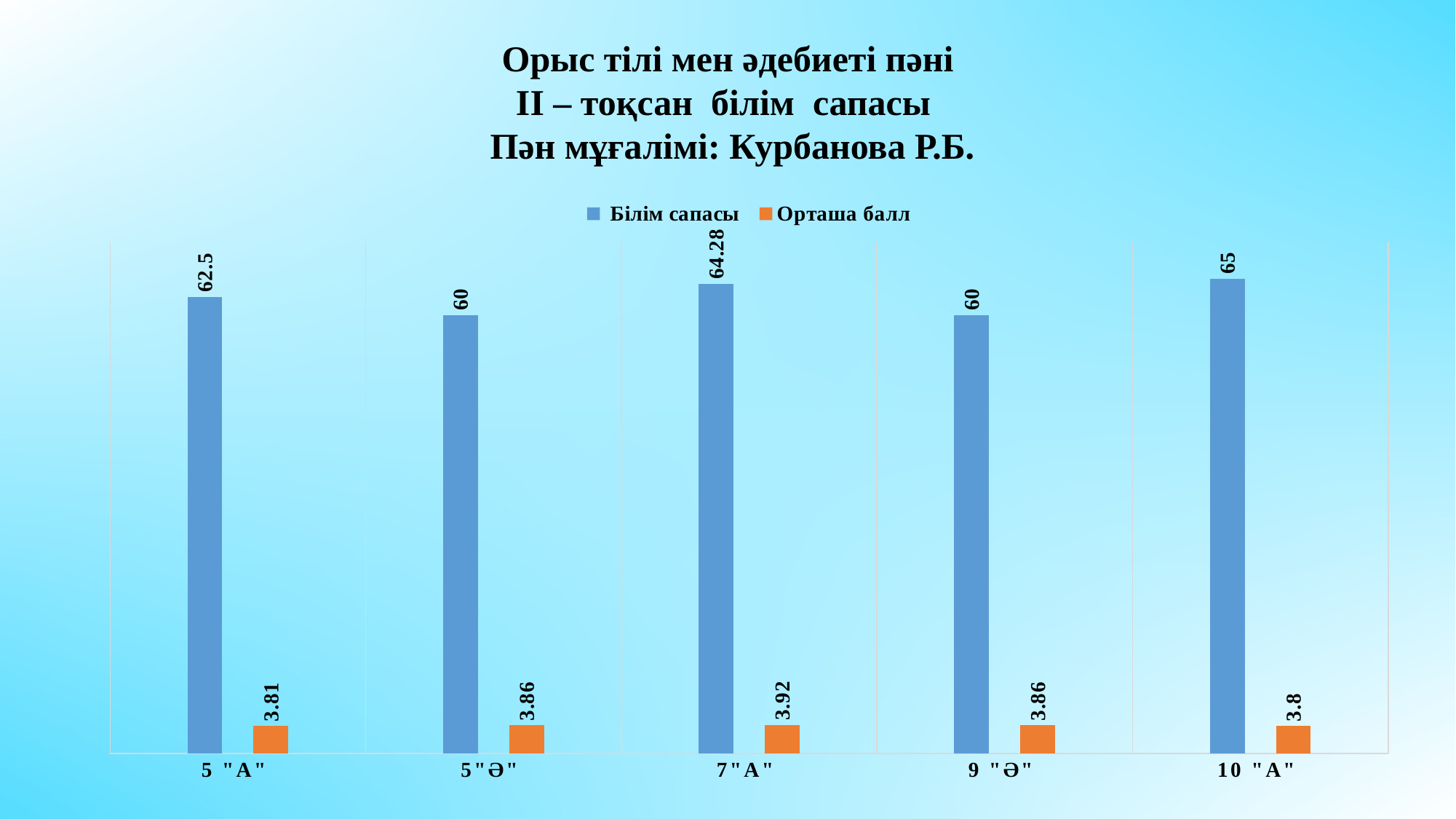
What kind of chart is shown on the slide? Bar chart What is the Орташа балл value for 5 "Ә"? 3.86 What is the Білім сапасы value for 7 "А"? 64.28 What is the Орташа балл value for 10 "А"? 3.8 Which class has the highest Орташа балл value? 7 "А" Which class has the lowest Орташа балл value? 10 "А" How many series does the legend list? 2 What is the difference between the Білім сапасы values for 10 "А" and 5 "А"? 2.5 What is the difference between the Орташа балл values for 7 "А" and 5 "А"? 0.11 Which class has the highest Білім сапасы value? 10 "А" How many classes are shown on the x axis? 5 Which is larger, the Білім сапасы value for 5 "А" or for 5 "Ә"? 5 "А"